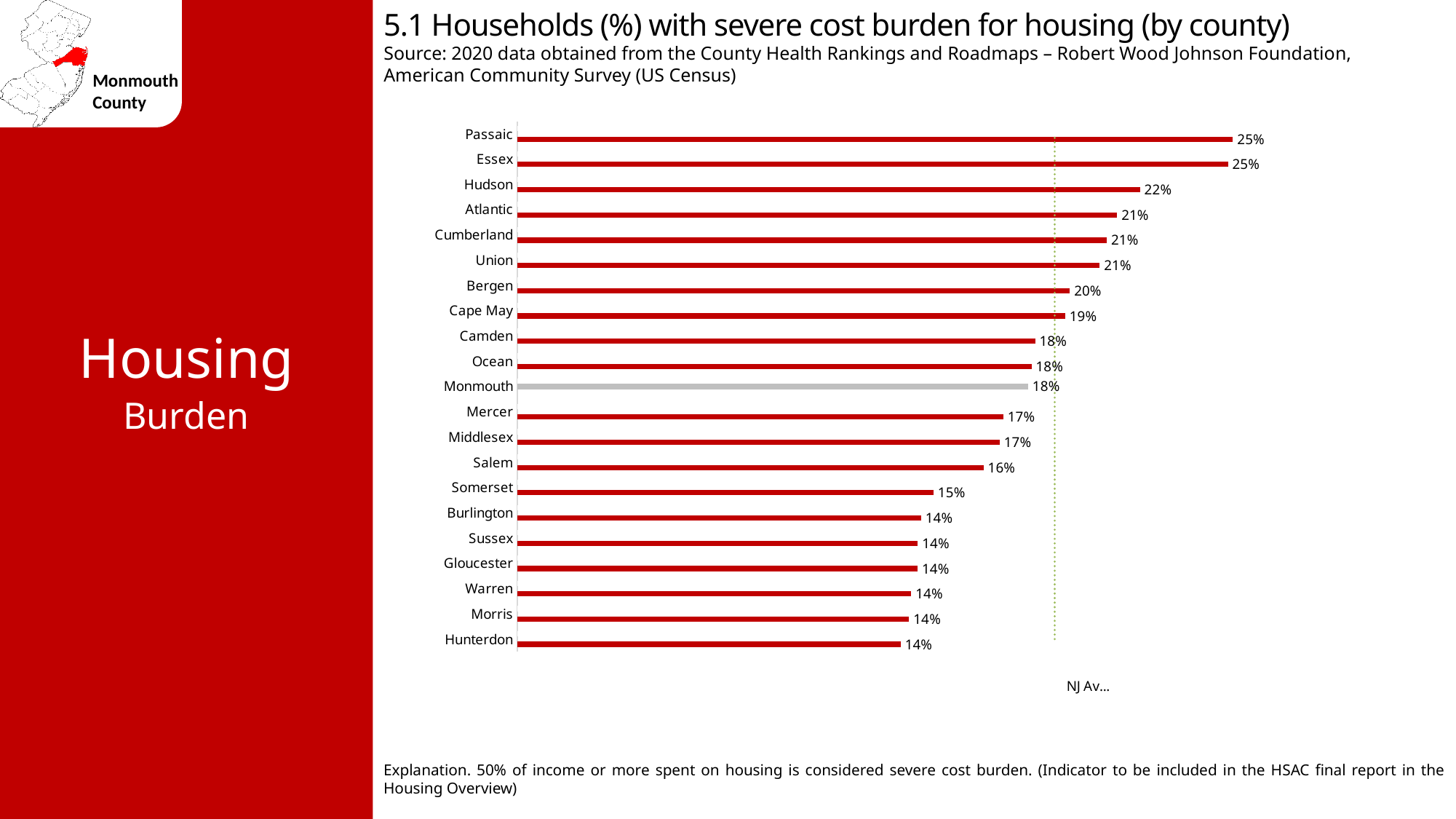
What kind of chart is shown on the slide? Bar chart What is the value for Monmouth? 18% What is the value for Hudson? 22% What is the difference between the values for Passaic and Monmouth? 7 percentage points What is the value for Cape May? 19% Which county's bar is coloured grey instead of red? Monmouth Which has a higher value, Hudson or Bergen? Hudson What is the lowest value shown in the chart? 14% What is the value for Somerset? 15% Which has a higher value, Monmouth or Somerset? Monmouth How many counties are listed in the chart? 21 What is the highest value shown in the chart? 25%